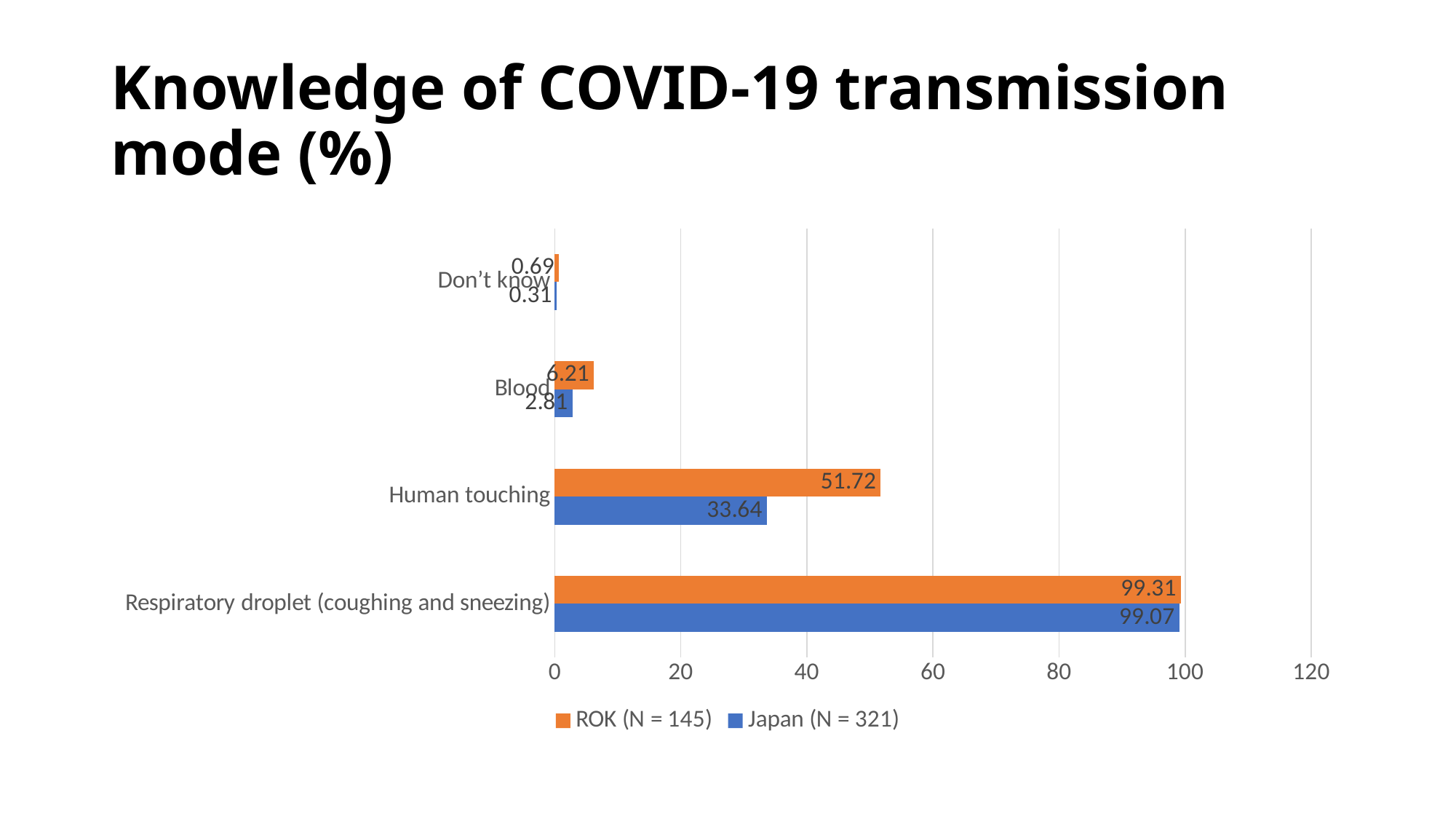
How many categories are shown on the chart? 4 How many series does the legend list? 2 What is the value for ROK (N = 145) for Human touching? 51.72 What is the value for Japan (N = 321) for Blood? 2.81 For Blood, which series has the larger value, ROK (N = 145) or Japan (N = 321)? ROK (N = 145) What kind of chart is shown on the slide? Bar chart What is the difference between the ROK (N = 145) and Japan (N = 321) values for Human touching? 18.08 Which category has the lowest value for ROK (N = 145)? Don't know Is the value for Japan (N = 321) for Human touching greater or less than 40? less Which category has the highest value for Japan (N = 321)? Respiratory droplet (coughing and sneezing) What is the value for ROK (N = 145) for Don't know? 0.69 What is the value for Japan (N = 321) for Respiratory droplet (coughing and sneezing)? 99.07